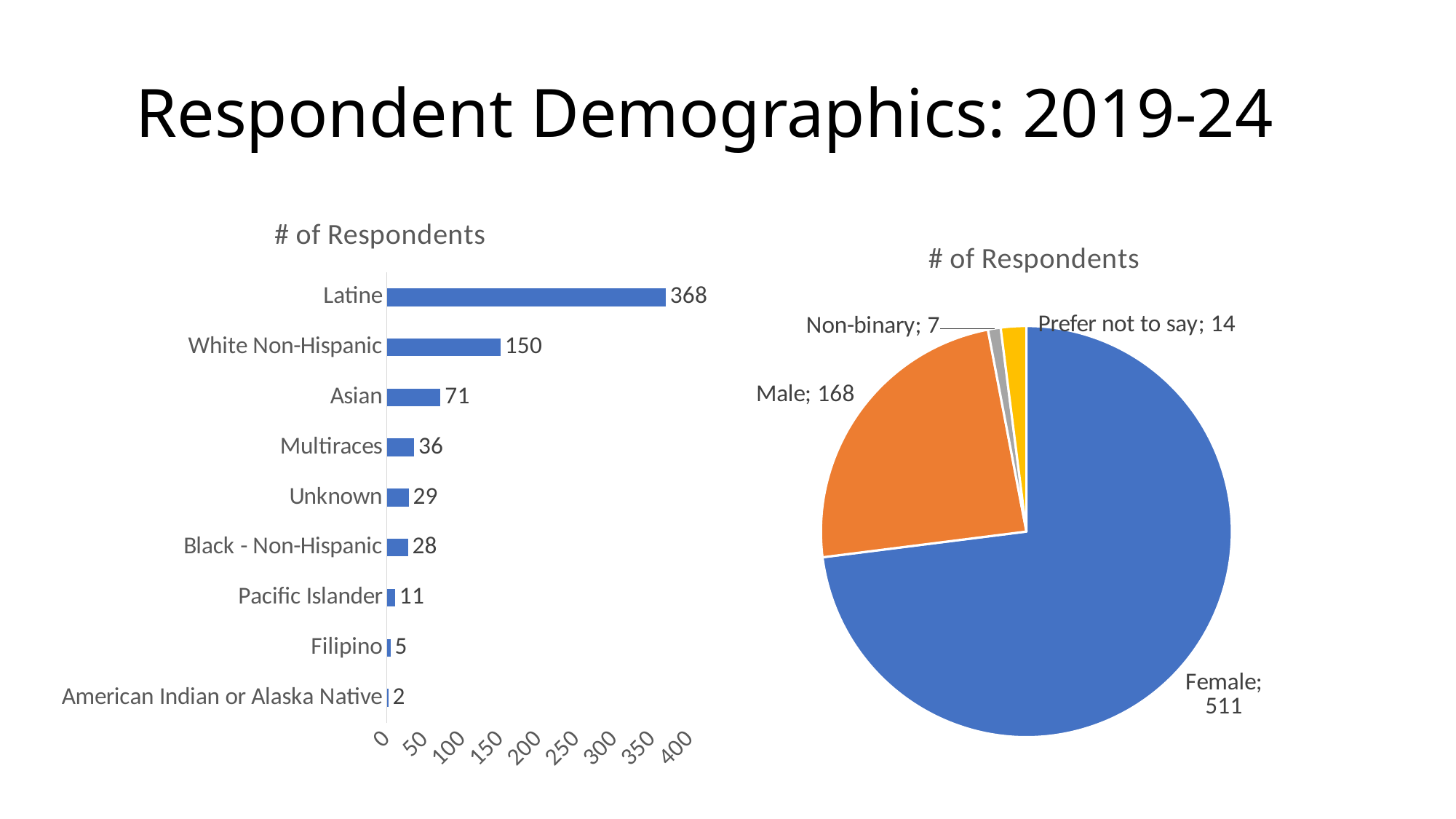
On the left bar chart, how many respondents are Asian? 71 On the left bar chart, how many respondents are Latine? 368 On the right pie chart, which category has the smallest slice? Non-binary What kind of chart is on the left side of the slide? Bar chart On the right pie chart, what is the total number of respondents across all slices? 700 On the left bar chart, what is the difference between the Latine and White Non-Hispanic respondent counts? 218 On the right pie chart, what share of respondents are Female, to the nearest percent? 73% How many categories are shown on the left bar chart? 9 On the right pie chart, how many respondents are Male? 168 On the left bar chart, which category has the highest number of respondents? Latine On the left bar chart, which has more respondents, Unknown or Black - Non-Hispanic? Unknown On the left bar chart, which category has the lowest number of respondents? American Indian or Alaska Native